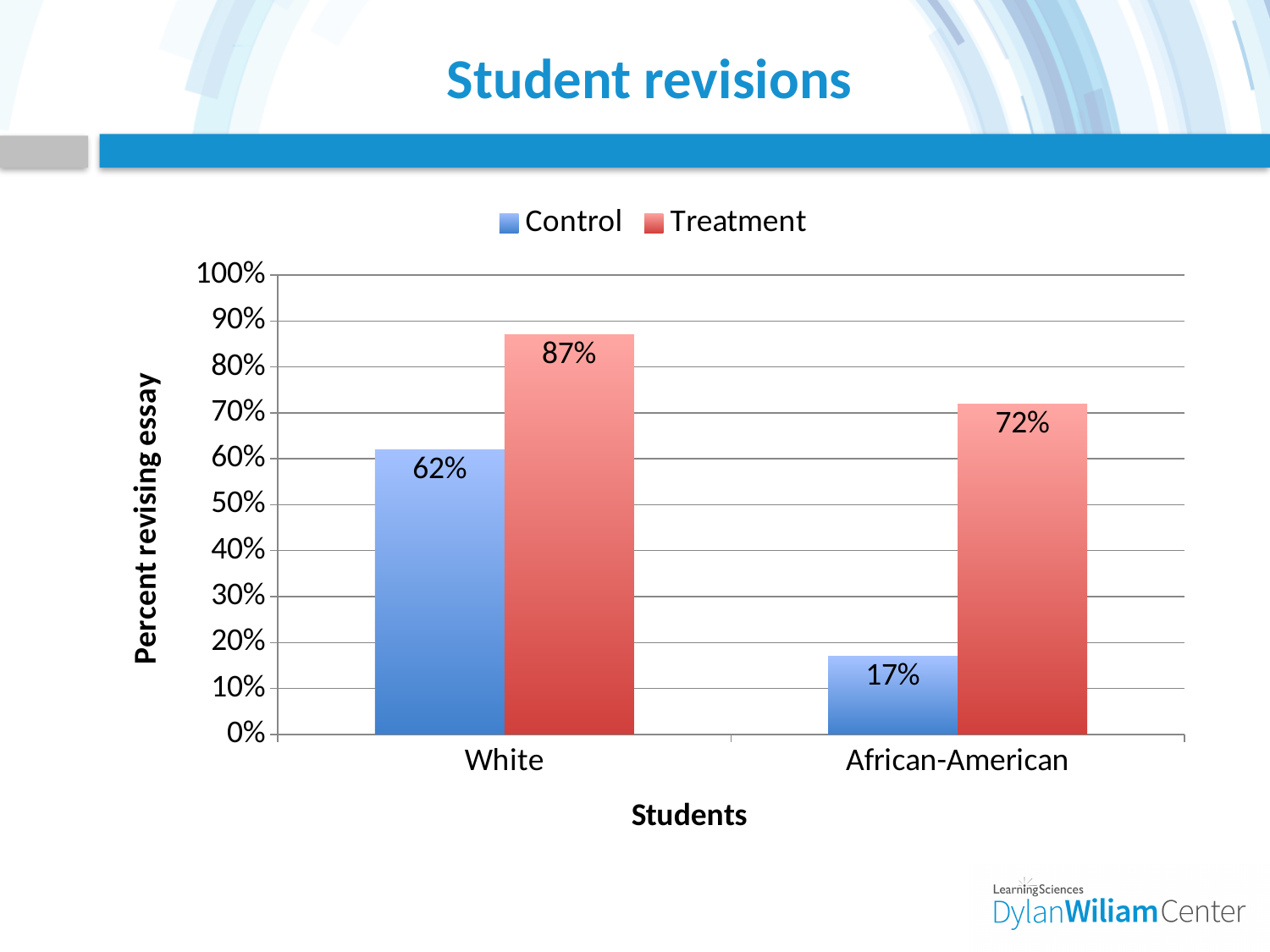
How many series does the legend list? 2 How many student categories are shown on the x axis? 2 What is the Control value for African-American students? 17% Which bar has the lowest value on the chart? Control, African-American What is the Treatment value for White students? 87% What kind of chart is shown on the slide? Bar chart What is the difference between the Treatment values for White and African-American students? 15% What is the Control value for White students? 62% Which is larger: the Control value for White students or the Treatment value for African-American students? Treatment value for African-American students Which bar has the highest value on the chart? Treatment, White What is the difference between the Treatment and Control values for African-American students? 55% What is the Treatment value for African-American students? 72%